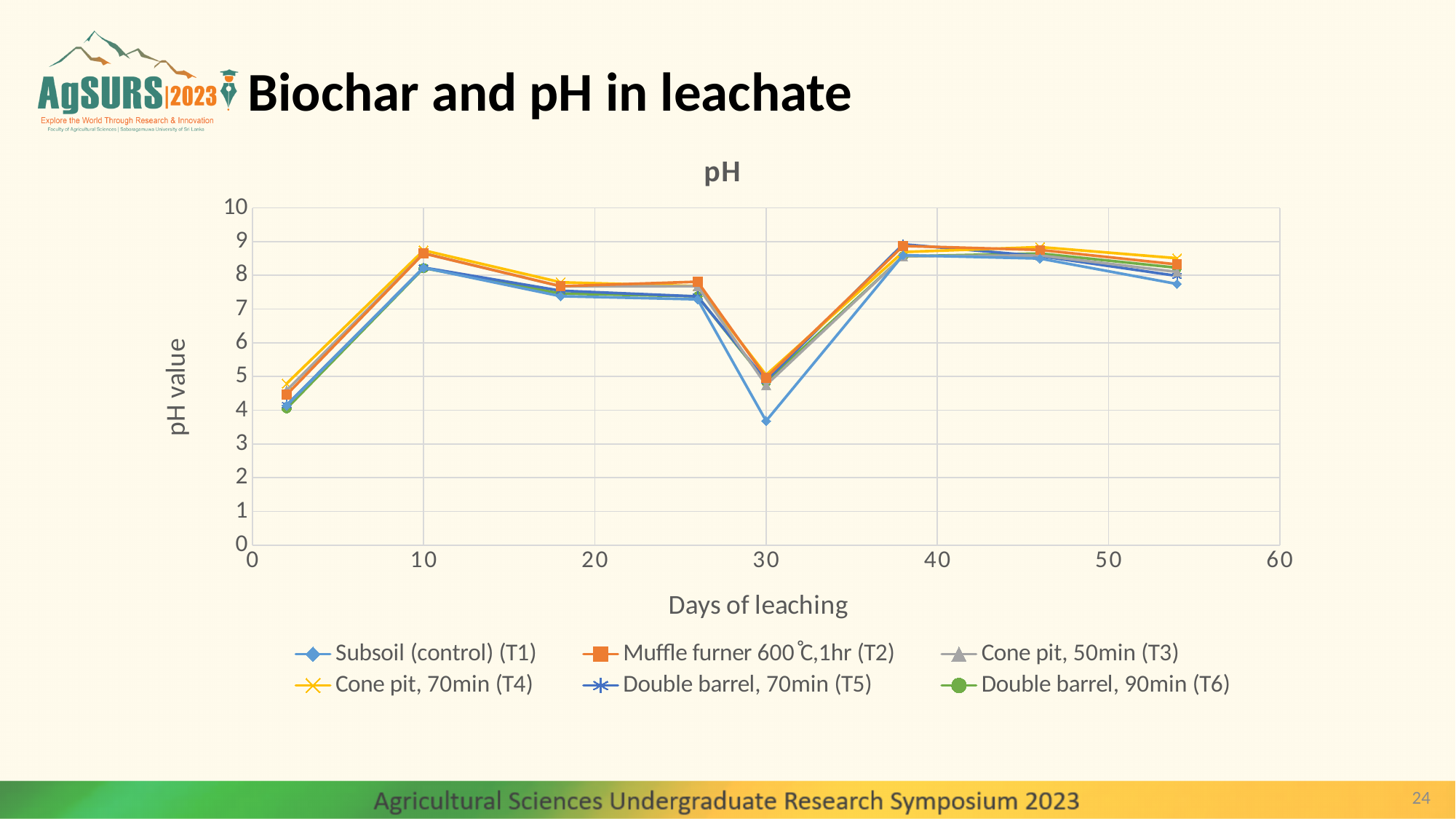
What kind of chart is shown on the slide? line chart Do the pH values rise or fall between day 26 and day 30? fall Which series has the lowest pH value at day 30? Subsoil (control) (T1) Is the pH value for Subsoil (control) (T1) at day 54 greater or less than 8? less Do the pH values rise or fall between day 2 and day 10? rise How many data points are plotted for each series? 8 What is the label of the x axis? Days of leaching Is the pH value for Subsoil (control) (T1) at day 2 greater or less than 5? less How many series does the legend list? 6 Is the pH value for Muffle furner 600℃,1hr (T2) at day 10 greater or less than 8? greater What is the title of the chart? pH